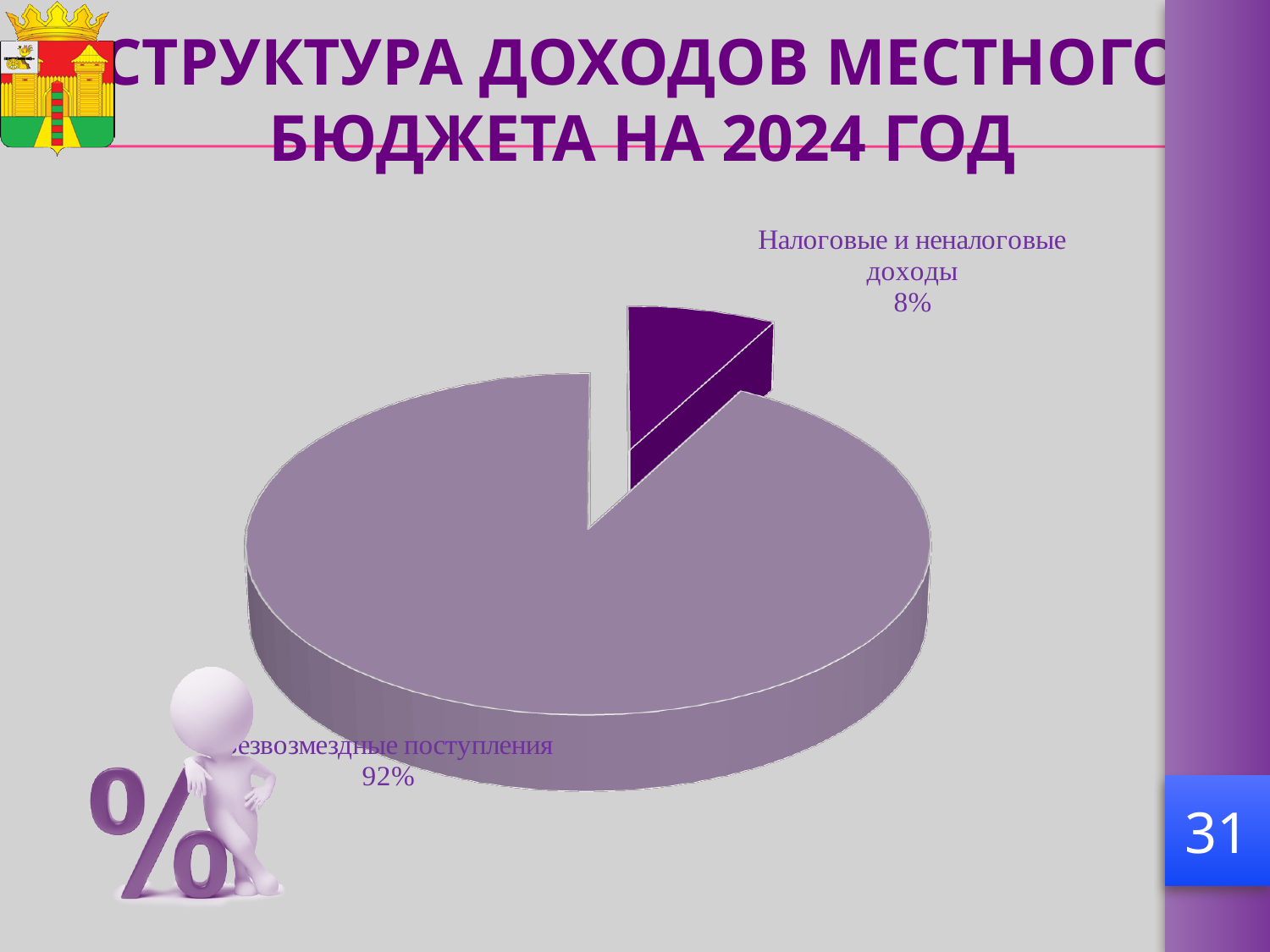
What is the value shown for "Налоговые и неналоговые доходы"? 8% Which is larger: "Налоговые и неналоговые доходы" or "Безвозмездные поступления"? Безвозмездные поступления What is the difference in percentage points between "Безвозмездные поступления" and "Налоговые и неналоговые доходы"? 84 What is the title of the slide containing the chart? СТРУКТУРА ДОХОДОВ МЕСТНОГО БЮДЖЕТА НА 2024 ГОД Which category has the largest slice of the pie? Безвозмездные поступления What kind of chart is shown on the slide? Pie chart How many slices does the pie chart have? 2 What share of the pie does "Налоговые и неналоговые доходы" have? 8% What share of the pie does "Безвозмездные поступления" have? 92% What is the value shown for "Безвозмездные поступления"? 92% Which slice is drawn in the darker purple colour? Налоговые и неналоговые доходы Which category has the smallest slice of the pie? Налоговые и неналоговые доходы